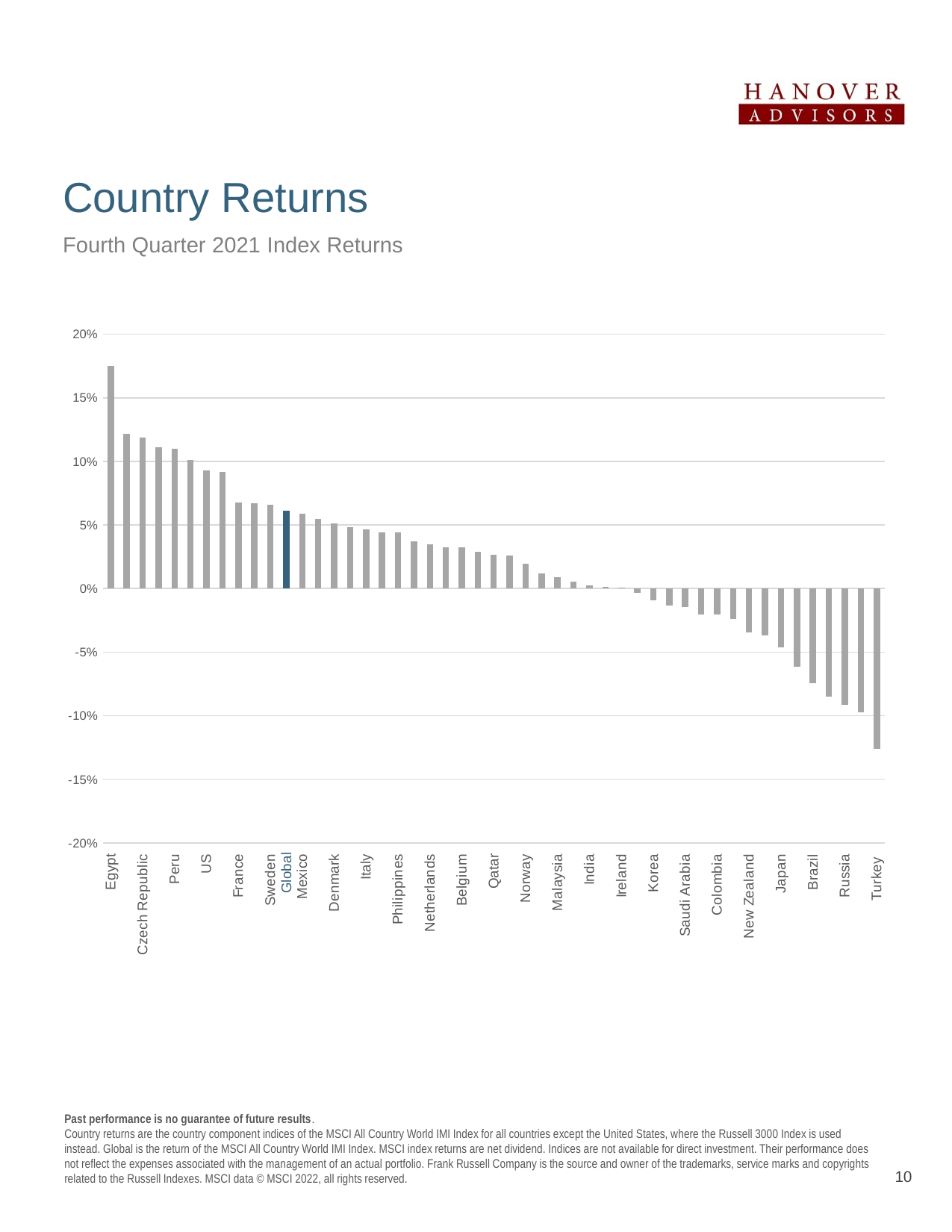
Is the value for Egypt greater or less than 15%? greater Do the values rise or fall moving from left to right along the x axis? Fall Is the value for Czech Republic greater or less than 10%? greater Is the value for Belgium greater or less than 5%? less What kind of chart is shown on the slide? Bar chart Which country has the lowest fourth quarter 2021 index return? Turkey Which country has the highest fourth quarter 2021 index return? Egypt Which bar is shown in a different colour (dark blue) from the rest? Global Which has the larger return, Czech Republic or Italy? Czech Republic